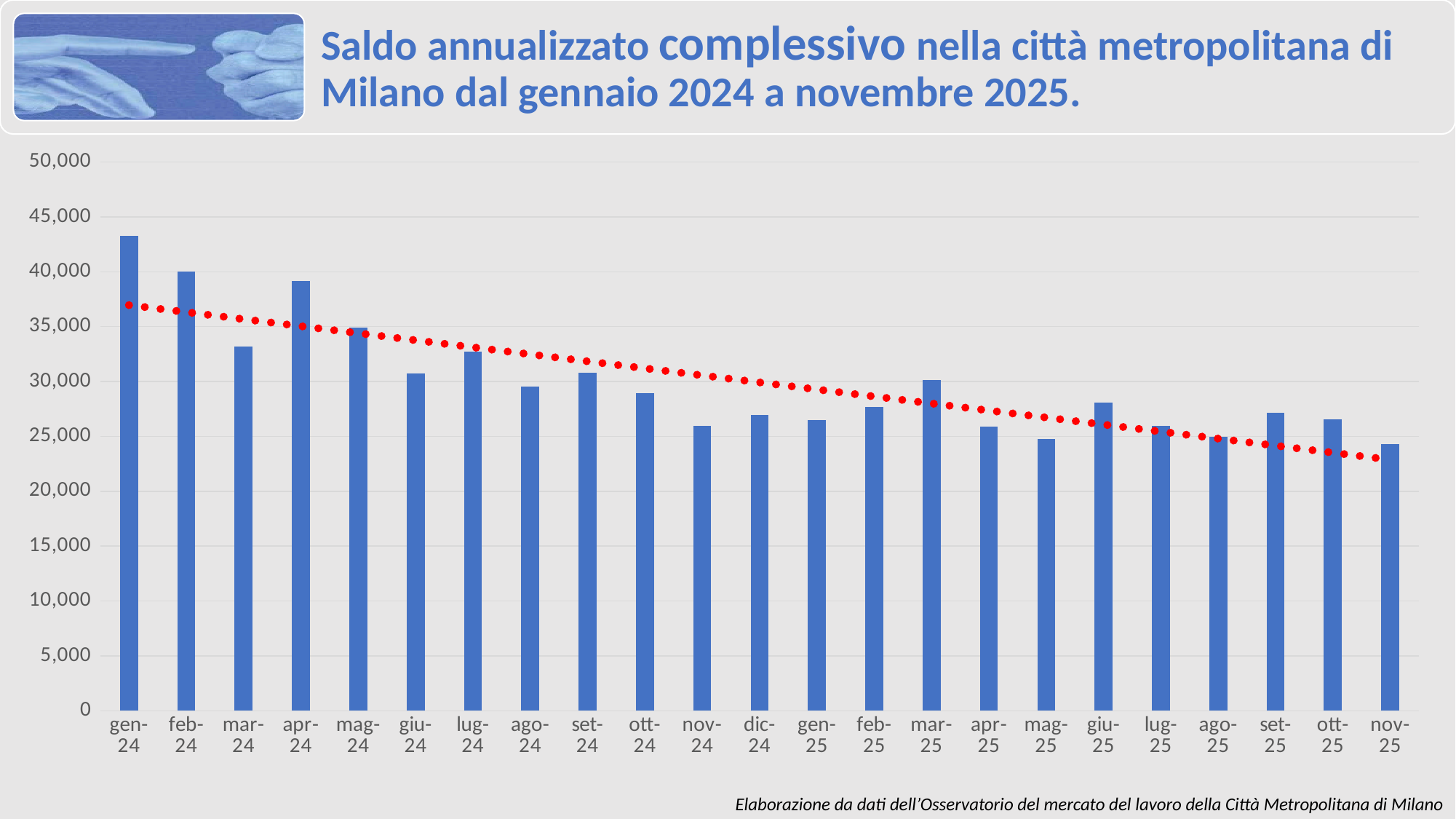
Which is larger, the value for mar-24 or the value for apr-24? apr-24 Is the value for nov-25 greater or less than 25,000? less Which is larger, the value for mar-25 or the value for apr-25? mar-25 Is the value for gen-24 greater or less than 40,000? greater Is the value for apr-24 greater or less than 35,000? greater What does the red dotted line on the chart represent? a trend line What is the title of the slide? Saldo annualizzato complessivo nella città metropolitana di Milano dal gennaio 2024 a novembre 2025. How many monthly bars are plotted in the chart? 23 What kind of chart is shown on the slide? bar chart Which month has the highest value in the chart? gen-24 Overall, do the values rise or fall from gen-24 to nov-25? fall